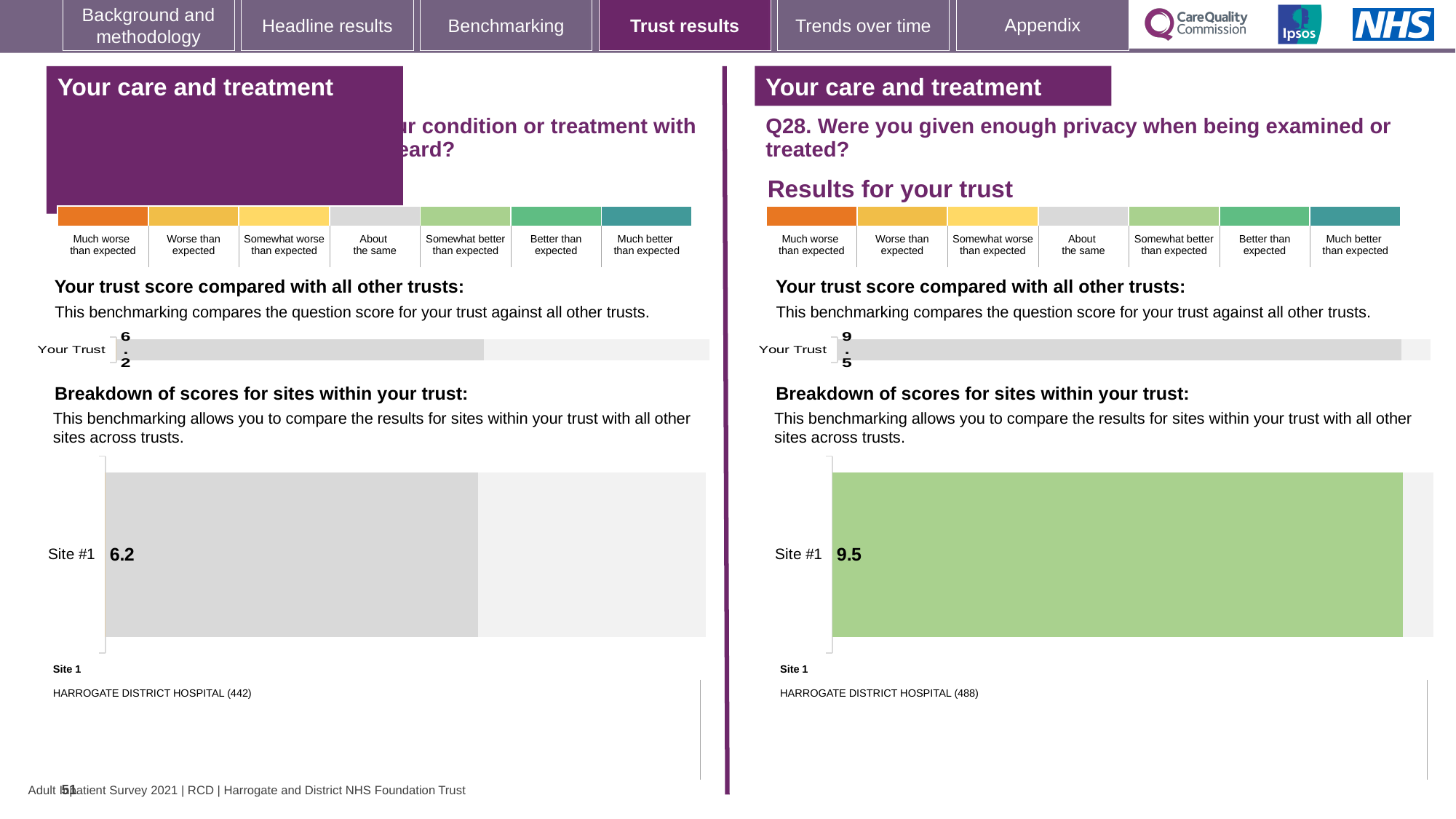
What colour is the Site #1 bar in the left-hand site breakdown chart? Grey What is the difference between the Site #1 score on the right-hand Q28 panel and the Site #1 score on the left-hand panel? 3.3 Which panel shows the higher Site #1 score, the left-hand panel or the right-hand Q28 panel? The right-hand Q28 panel In the right-hand (Q28) 'Breakdown of scores for sites within your trust' chart, what is the score for Site #1? 9.5 How many sites are shown in the left-hand 'Breakdown of scores for sites within your trust' chart? 1 What colour is the Site #1 bar in the right-hand (Q28) site breakdown chart? Light green On the right-hand panel (Q28), what is the score shown for Your Trust in the 'Your trust score compared with all other trusts' chart? 9.5 In the left-hand 'Breakdown of scores for sites within your trust' chart, what is the score for Site #1? 6.2 On the left-hand panel, what is the score shown for Your Trust in the 'Your trust score compared with all other trusts' chart? 6.2 What type of chart is used for the 'Breakdown of scores for sites within your trust' on the right-hand Q28 panel? Bar chart How many sites are shown in the right-hand (Q28) 'Breakdown of scores for sites within your trust' chart? 1 Which site is listed as Site 1 beneath the right-hand (Q28) site breakdown chart? HARROGATE DISTRICT HOSPITAL (488)